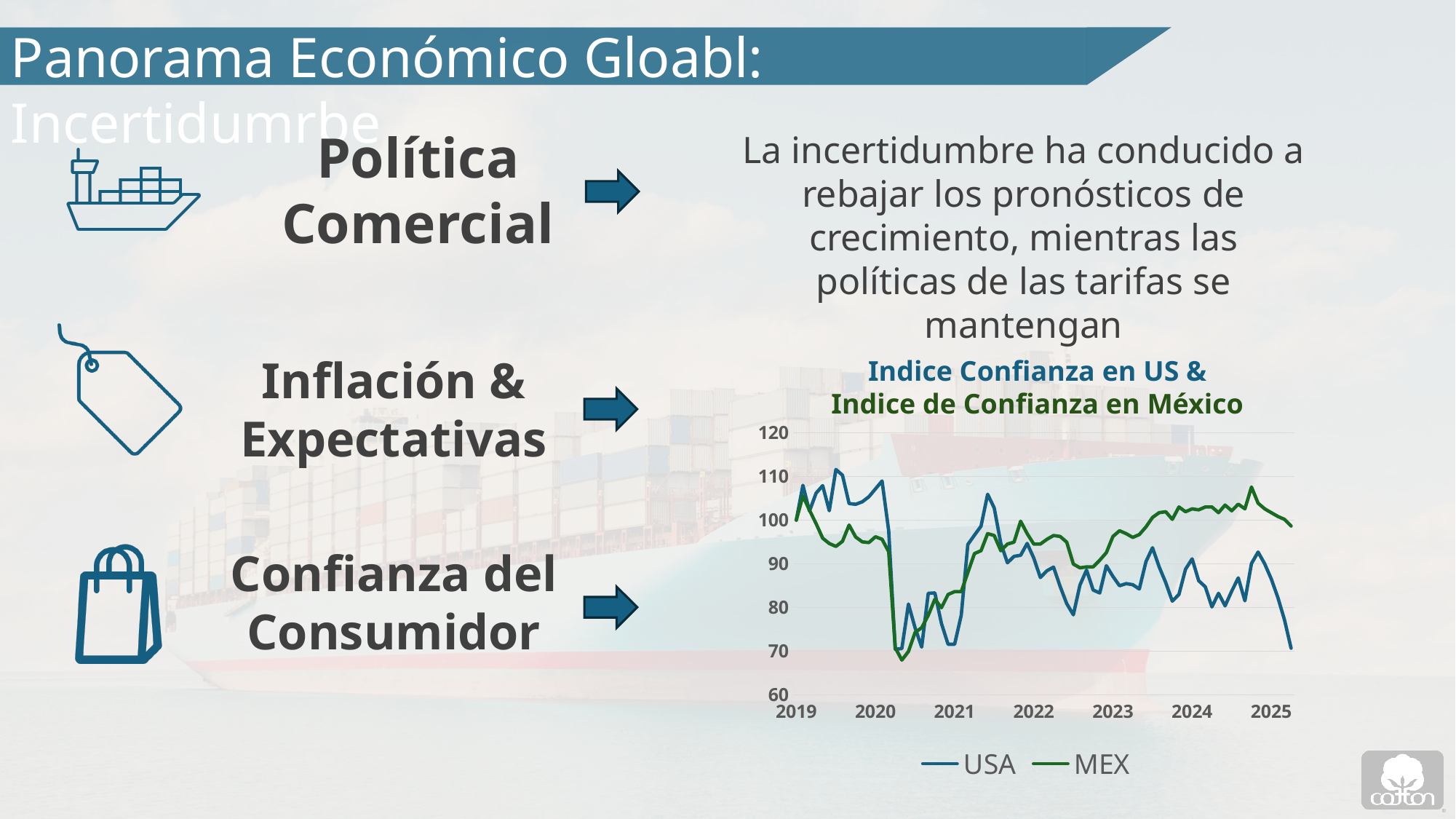
Does the USA line rise or fall from the end of 2024 to the end of 2025? fall What are the two series named in the chart legend? USA and MEX Is the lowest value of the USA line in 2020 greater or less than 80? less What colour is the MEX line in the chart? green How many series does the chart legend list? 2 Is the value of the MEX line at the end of 2025 greater or less than 90? greater What is the highest value shown on the chart's vertical axis? 120 At the end of 2025, which line is higher, USA or MEX? MEX What kind of chart is shown on the slide? line chart Is the value of the USA line at the end of 2025 greater or less than 80? less What is the first year and the last year labelled on the chart's horizontal axis? 2019 and 2025